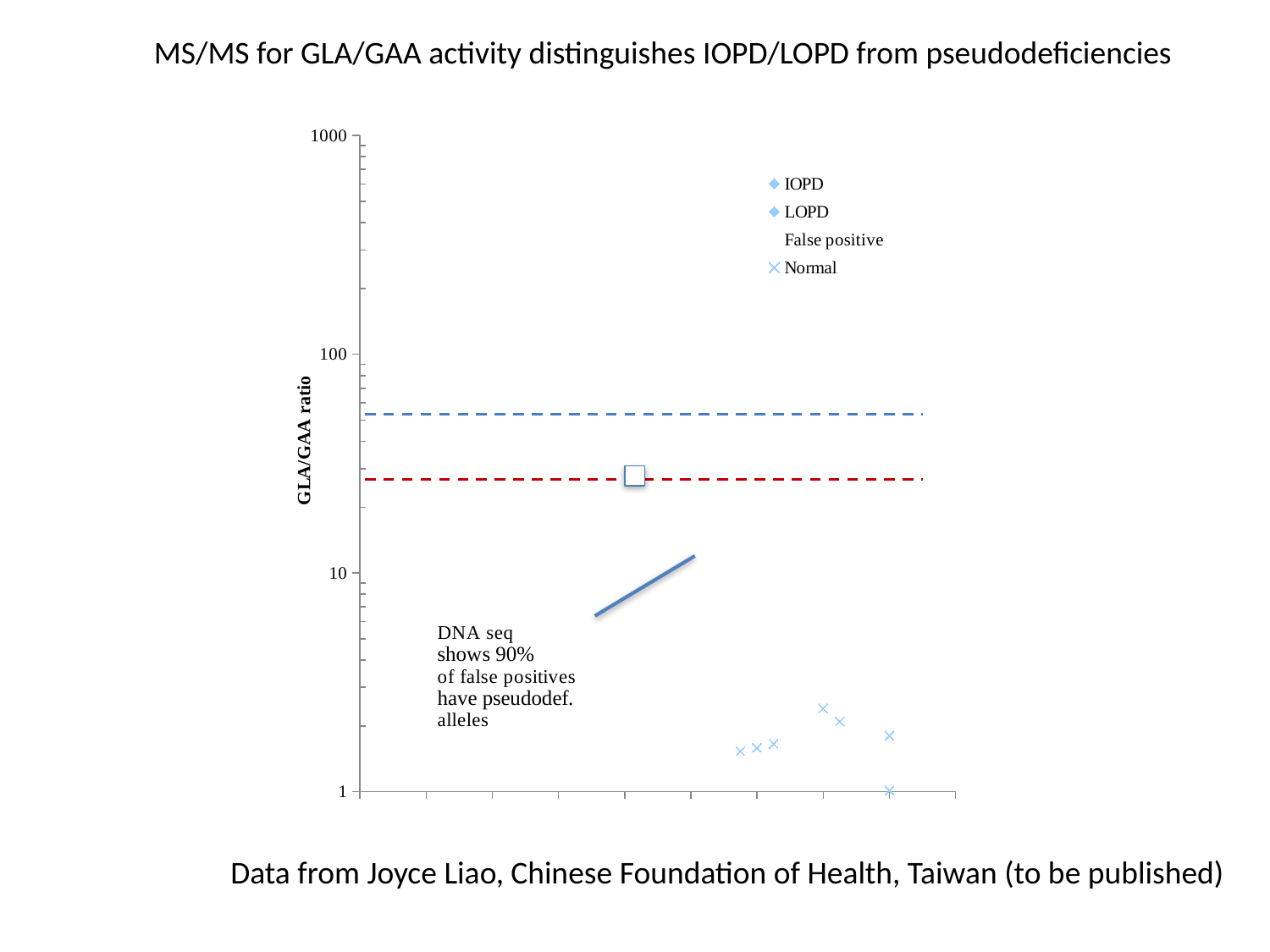
Is the red dashed horizontal line greater or less than 10 on the GLA/GAA ratio axis? greater What is the lowest tick value shown on the y axis? 1 How many series does the chart's legend list? 4 What kind of chart is shown on the slide? scatter chart Is the blue dashed horizontal line greater or less than 100 on the GLA/GAA ratio axis? less Is the highest plotted Normal point greater or less than 100 on the GLA/GAA ratio axis? less What is the highest tick value shown on the y axis? 1000 What is the label on the chart's y axis? GLA/GAA ratio Which series in the legend is marked with an x symbol? Normal